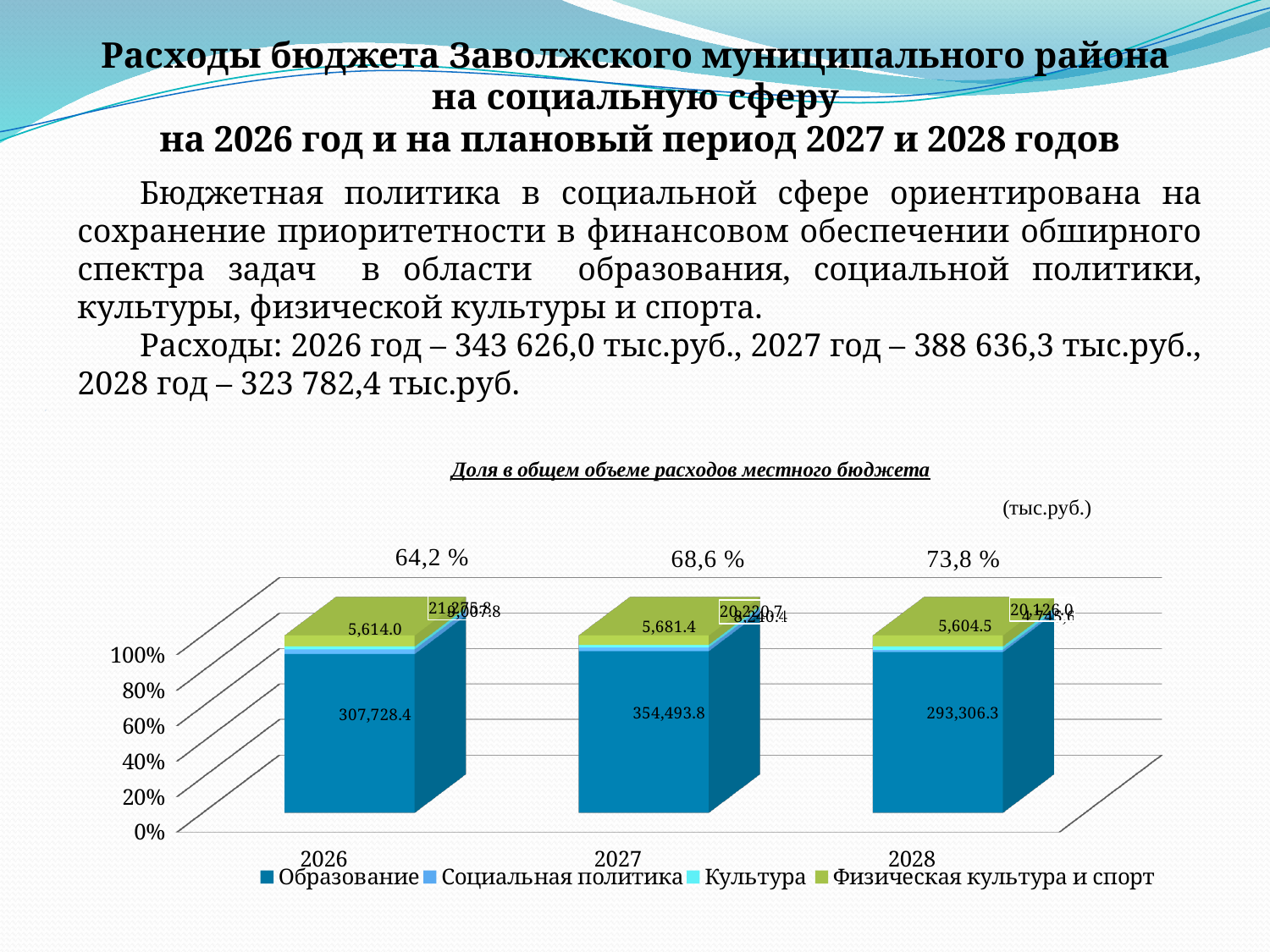
In which year is the value for Образование the highest? 2027 What is the value for Образование in 2028? 293,306.3 What is the value for Образование in 2026? 307,728.4 What percentage is shown above the bar for 2028? 73,8 % What is the value for Социальная политика in 2027? 8,240.4 What is the difference between the Образование values for 2027 and 2026? 46,765.4 How many series does the legend list? 4 What type of chart is shown on the slide? Stacked bar chart What is the value for Социальная политика in 2028? 4,745.6 What is the title of the chart? Доля в общем объеме расходов местного бюджета What is the value for Образование in 2027? 354,493.8 In which year is the value for Образование the lowest? 2028